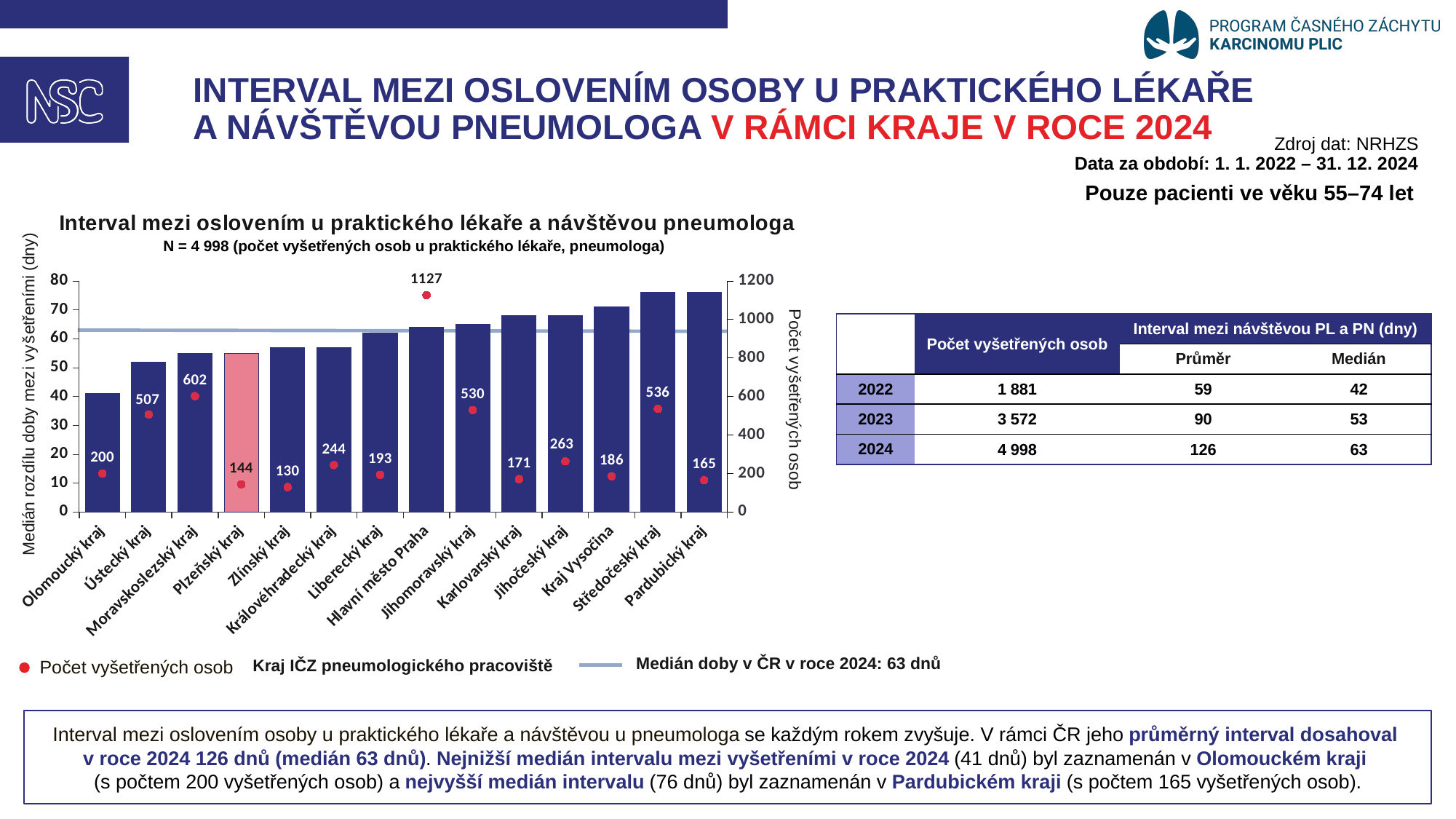
Is the median interval bar for Pardubický kraj greater or less than 70 days? greater Which has more examined persons, Ústecký kraj or Moravskoslezský kraj? Moravskoslezský kraj What is the number of examined persons for Moravskoslezský kraj? 602 What value does the horizontal reference line in the chart represent? Medián doby v ČR v roce 2024: 63 dnů What is the number of examined persons (Počet vyšetřených osob) for Hlavní město Praha? 1127 What is the difference between the number of examined persons in Hlavní město Praha and in Zlínský kraj? 997 Which region has the lowest number of examined persons? Zlínský kraj Is the median interval bar for Olomoucký kraj greater or less than 50 days? less How many regions are shown on the x axis of the chart? 14 Do the median interval bars rise or fall from left to right across the regions? rise What kind of chart is used to show the median interval by region? bar chart Which region has the highest number of examined persons? Hlavní město Praha